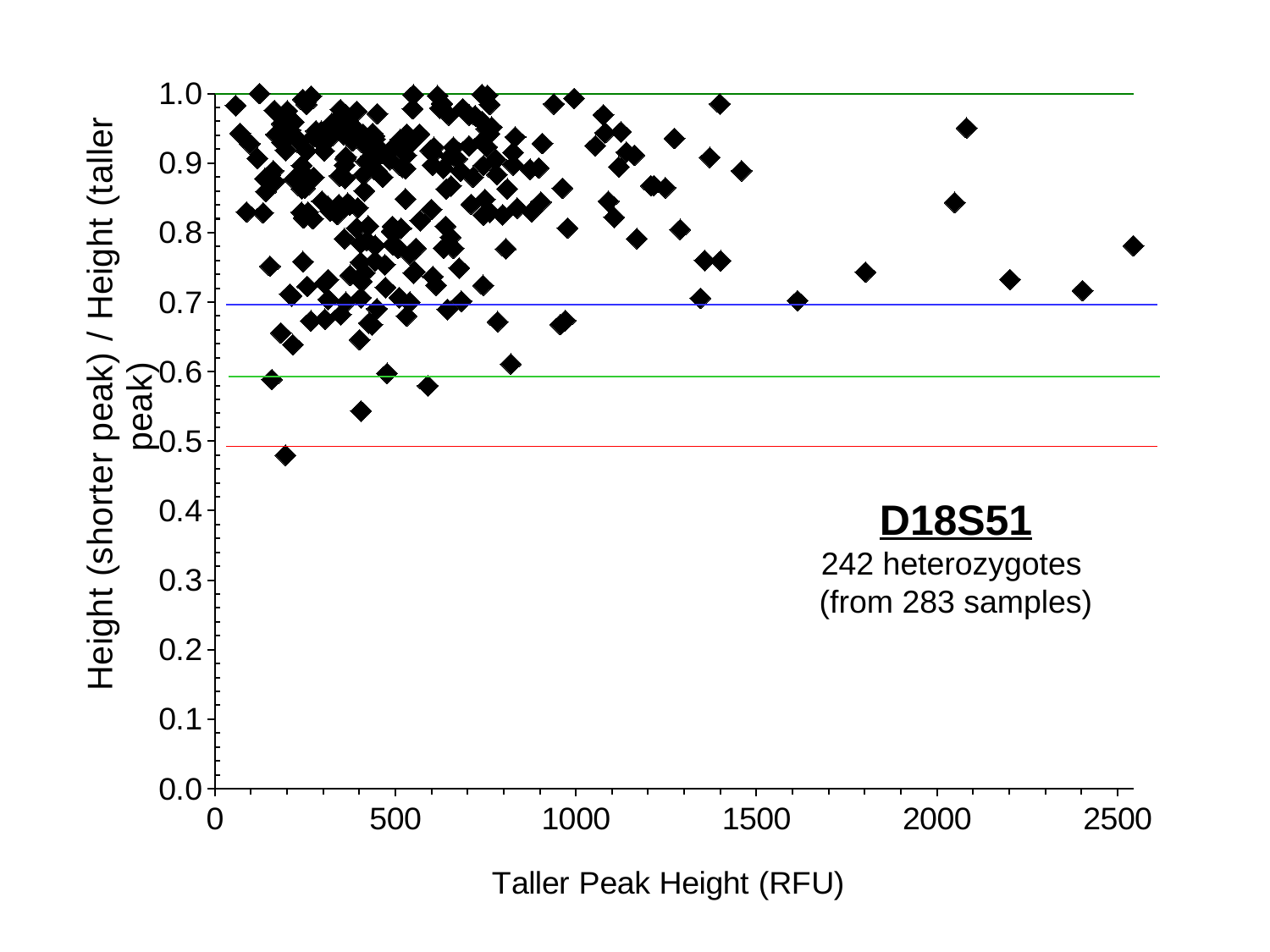
What is the label of the x axis? Taller Peak Height (RFU) What is the highest tick value shown on the x axis? 2500 Is the ratio for the point with the largest taller peak height (near 2500 RFU) greater or less than 0.7? greater What is the highest tick value shown on the y axis? 1.0 What kind of chart is shown on the slide? Scatter plot Is the ratio for the lowest plotted point (near 200 RFU) greater or less than 0.5? less Is the ratio for the point near 1800 RFU greater or less than 0.8? less Which locus name is printed on the chart? D18S51 According to the text on the chart, how many heterozygotes are plotted? 242 Do the plotted points become more or less dense as taller peak height increases along the x axis? less dense